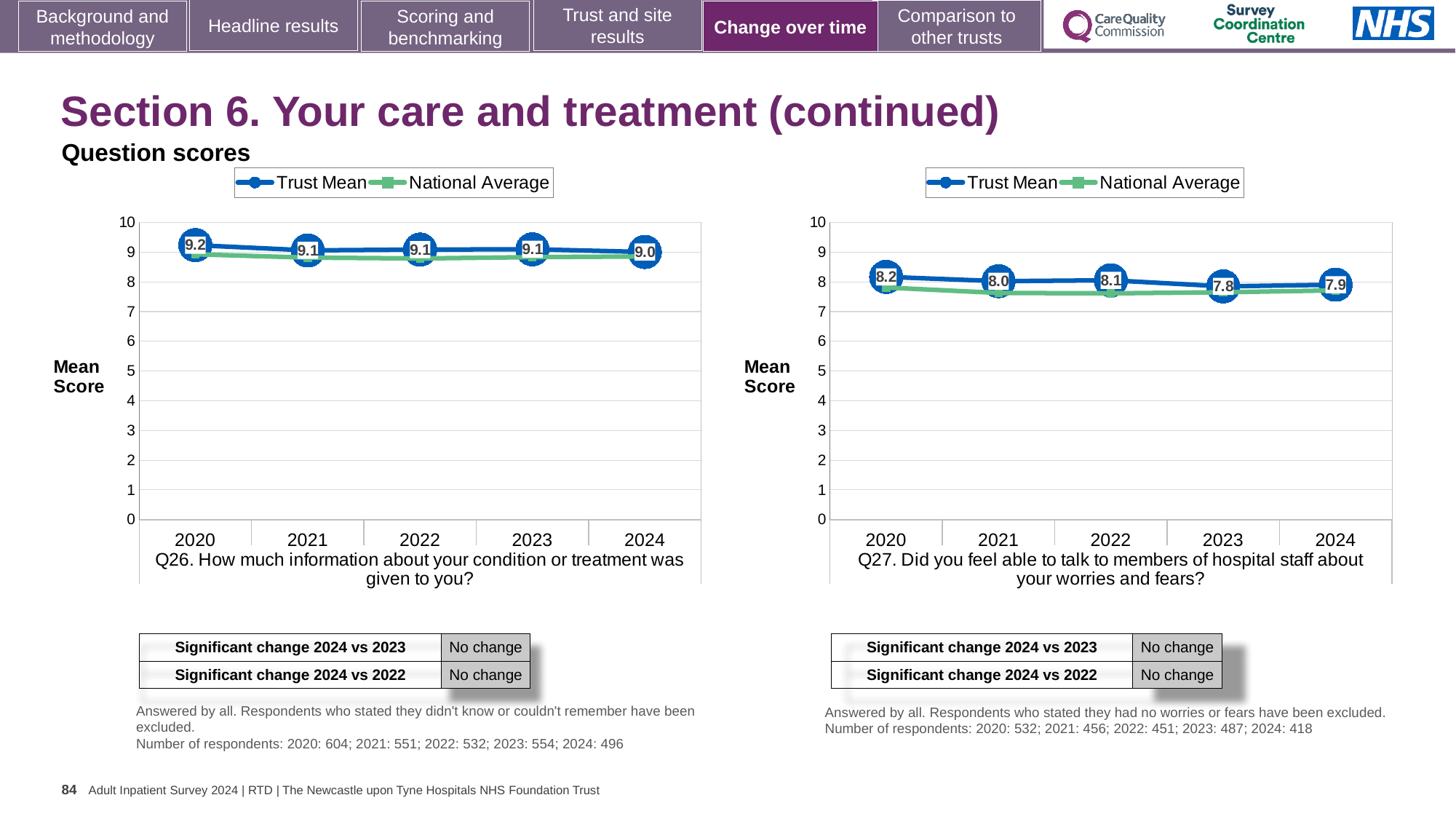
In the Q27 chart on the right, which year has the lowest Trust Mean score? 2023 In the Q27 chart on the right, what is the difference between the Trust Mean scores for 2020 and 2023? 0.4 In the Q26 chart on the left, what is the Trust Mean score for 2020? 9.2 In the Q26 chart on the left, what is the Trust Mean score for 2024? 9.0 In the Q26 chart on the left, what is the difference between the Trust Mean scores for 2020 and 2024? 0.2 In the Q27 chart on the right, which year has the highest Trust Mean score? 2020 In the Q27 chart on the right, what is the Trust Mean score for 2024? 7.9 How many years are plotted on the x axis of the Q27 chart on the right? 5 How many series does the legend of the Q26 chart on the left list? 2 In the Q26 chart on the left, is the National Average value for 2020 greater or less than 8? greater In the Q26 chart on the left, is the Trust Mean score higher in 2020 or in 2024? 2020 In the Q27 chart on the right, what is the Trust Mean score for 2023? 7.8